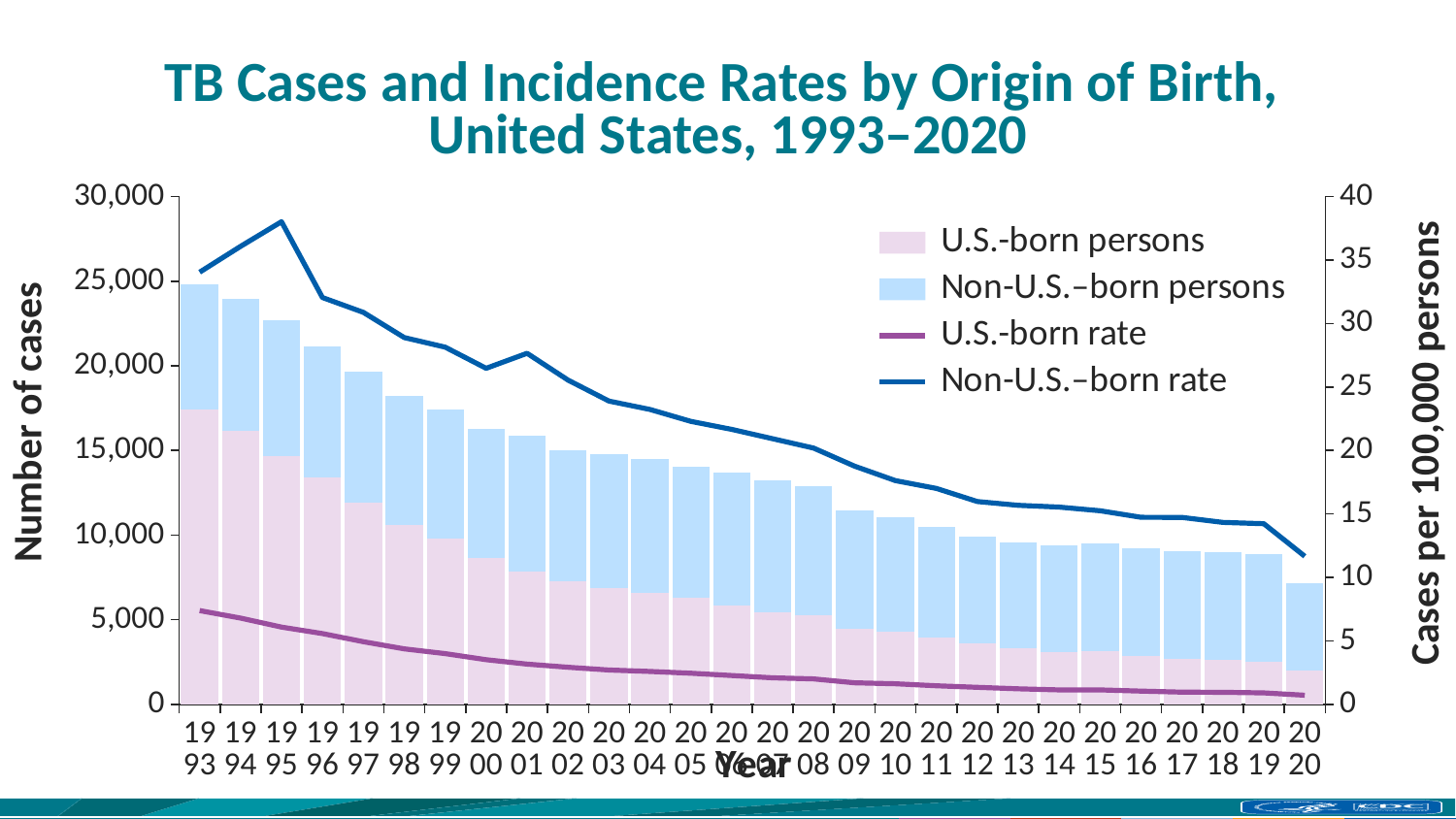
In which year is the Non-U.S.–born rate highest? 1995 How many years are shown along the x axis? 28 In 1993, which group accounts for more cases, U.S.-born persons or Non-U.S.–born persons? U.S.-born persons In 2020, which group accounts for more cases, U.S.-born persons or Non-U.S.–born persons? Non-U.S.–born persons What kind of chart is shown on the slide? A combination of a stacked bar chart and a line chart How many series does the legend list? 4 Is the U.S.-born rate in 1993 greater or less than 5 cases per 100,000 persons? greater Is the Non-U.S.–born rate in 2020 greater or less than 15 cases per 100,000 persons? less Is the total number of TB cases in 2020 greater or less than 10,000? less In which year is the Non-U.S.–born rate lowest? 2020 Does the U.S.-born rate rise or fall from 1993 to 2020? fall